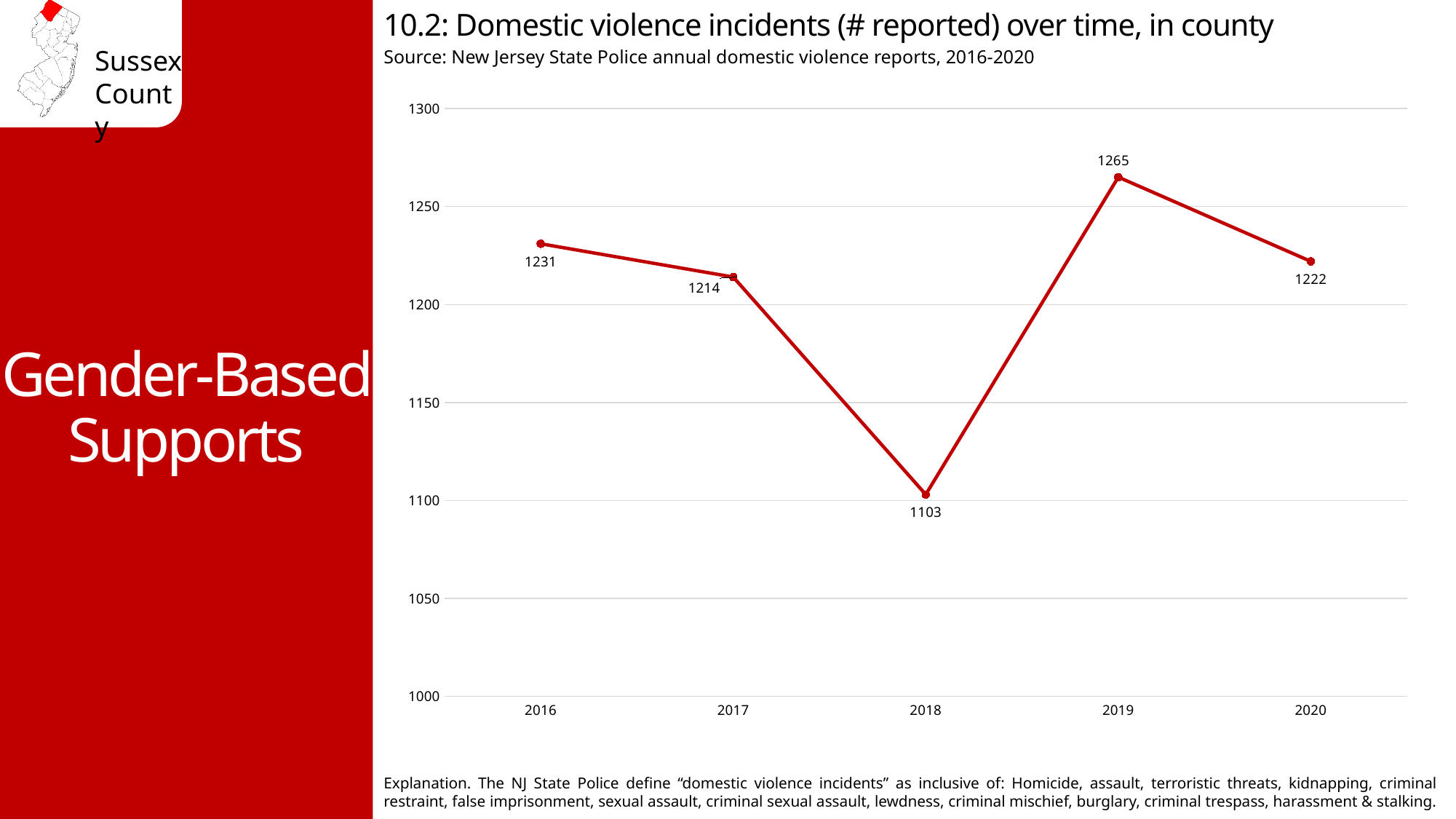
What was the number of reported domestic violence incidents in 2018? 1103 What was the number of reported domestic violence incidents in 2020? 1222 Which year had more reported incidents, 2016 or 2020? 2016 What is the difference between the number of incidents in 2019 and 2018? 162 Did the number of reported incidents rise or fall from 2018 to 2019? rise What was the number of reported domestic violence incidents in 2016? 1231 Which year had the lowest number of reported domestic violence incidents? 2018 Is the value for 2017 greater or less than 1200? greater How many years are plotted on the chart? 5 Which year had the highest number of reported domestic violence incidents? 2019 What kind of chart is shown on the slide? line chart What is the difference between the number of incidents in 2016 and 2017? 17